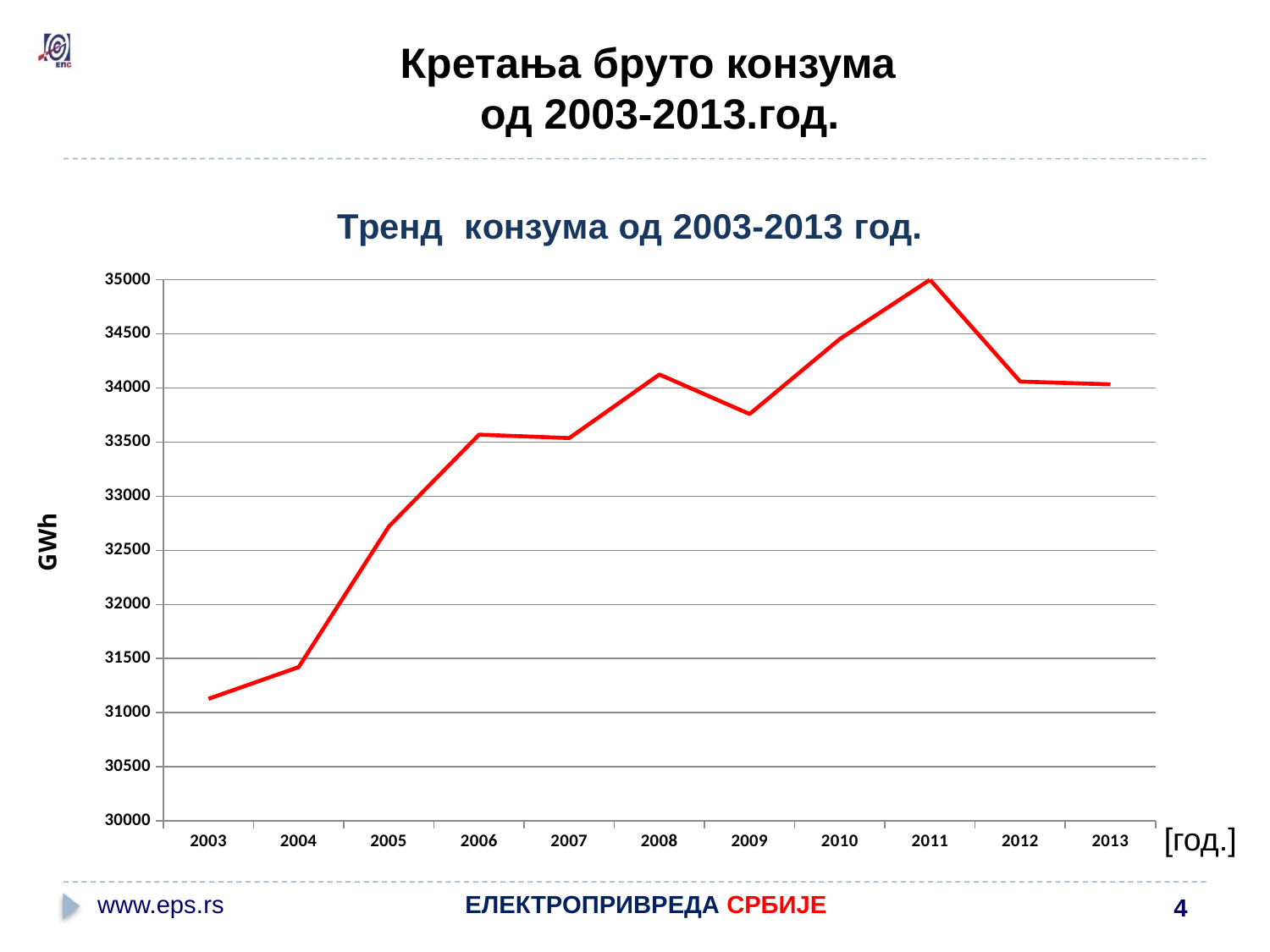
Which year has the larger value, 2005 or 2008? 2008 How many years are plotted on the x axis of the chart? 11 Which year has the highest value in the chart? 2011 Is the value for 2003 greater or less than 31500? less Overall, do the values rise or fall from 2003 to 2011? rise Which year has the larger value, 2011 or 2012? 2011 Is the value for 2009 greater or less than 34000? less Is the value for 2010 greater or less than 34000? greater Which year has the lowest value in the chart? 2003 What unit is shown on the y axis label of the chart? GWh What kind of chart is shown on the slide? line chart